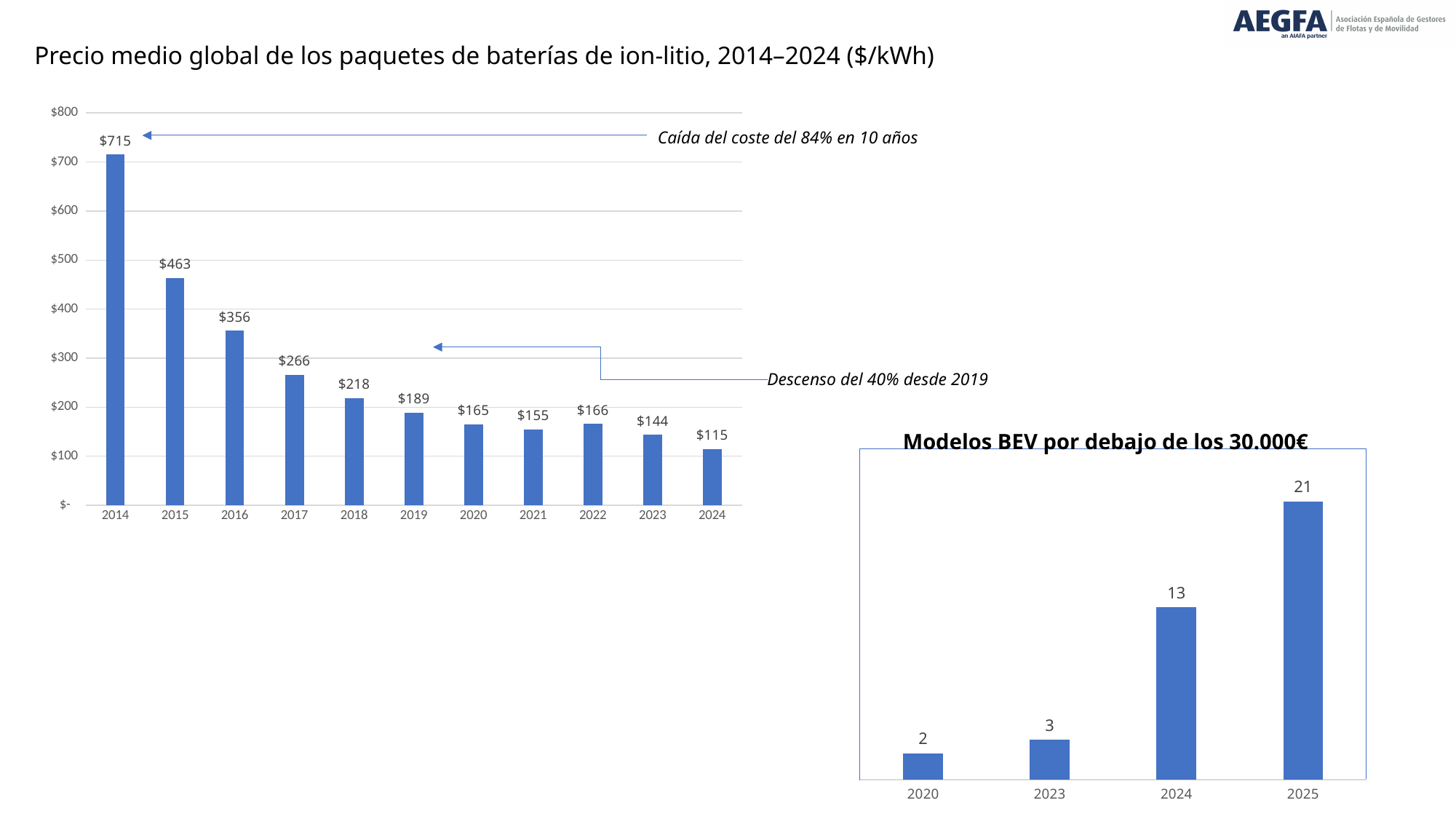
In the battery pack price chart, which is larger, the value for 2021 or the value for 2022? 2022 In the battery pack price chart, how many years are shown on the x axis? 11 What kind of chart is the 'Modelos BEV por debajo de los 30.000€' chart? bar chart In the 'Modelos BEV por debajo de los 30.000€' chart, what is the value for 2024? 13 In the battery pack price chart, what is the difference between the 2014 and 2024 values? $600 In the battery pack price chart, which year has the lowest value? 2024 In the 'Modelos BEV por debajo de los 30.000€' chart, which year has the highest value? 2025 In the battery pack price chart, do the values generally rise or fall from 2014 to 2024? fall In the battery pack price chart, what is the value for 2014? $715 In the battery pack price chart, what is the value for 2019? $189 In the 'Modelos BEV por debajo de los 30.000€' chart, what is the difference between the 2025 and 2024 values? 8 In the battery pack price chart, what is the value for 2024? $115